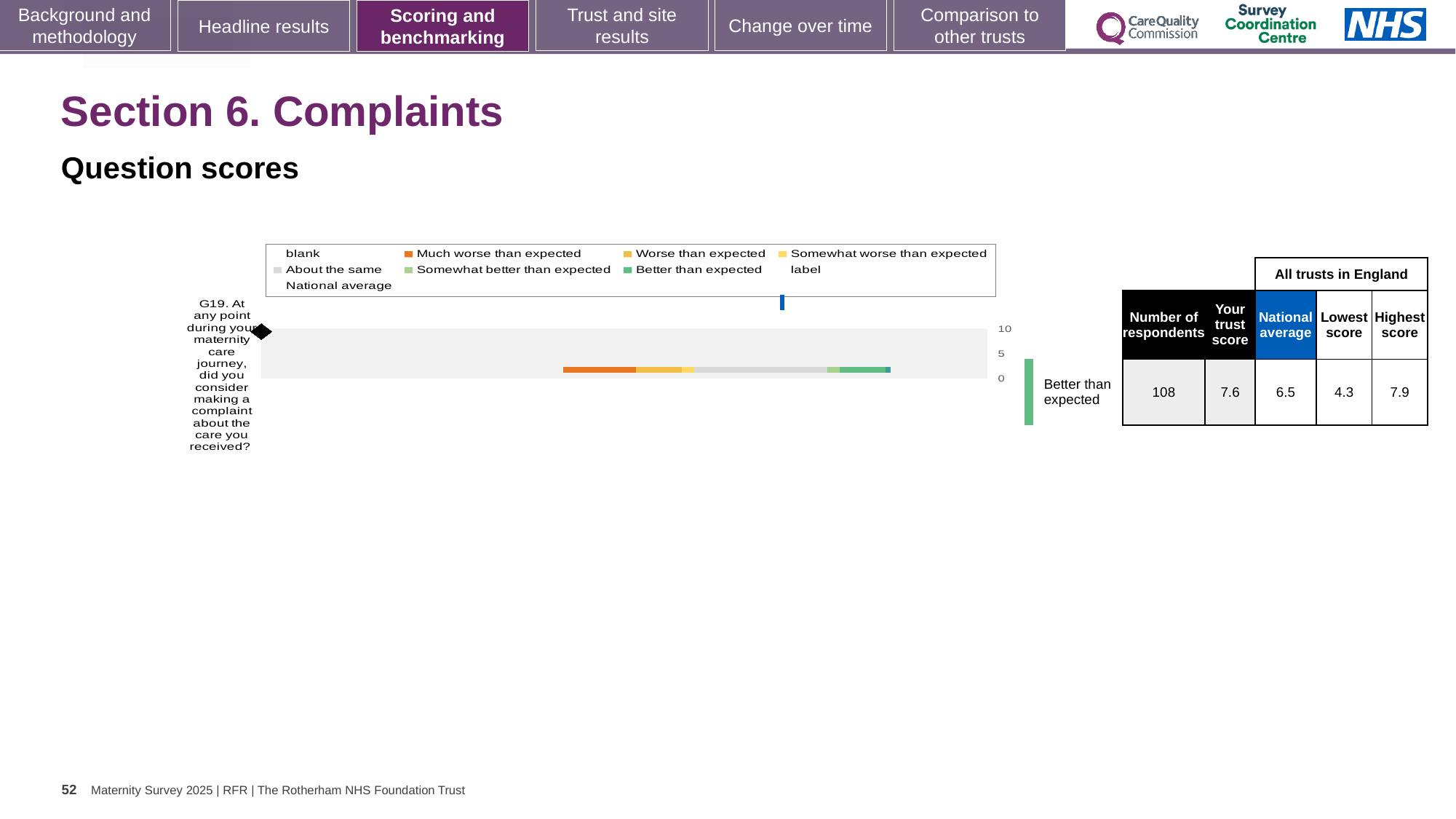
What is the trust score for G19 shown next to the chart? 7.6 What is the national average score for G19? 6.5 Is the trust score for G19 higher or lower than the national average? higher What is the difference between the highest and lowest scores for G19 across all trusts in England? 3.6 What kind of chart is shown for question G19? bar chart Which survey question is plotted in the chart? G19. At any point during your maternity care journey, did you consider making a complaint about the care you received? Which benchmark category does the trust's result for G19 fall into? Better than expected How many respondents answered question G19? 108 What is the lowest score among all trusts in England for G19? 4.3 What is the highest score among all trusts in England for G19? 7.9 What is the difference between the trust score and the national average for G19? 1.1 What is the highest tick value shown on the chart's score axis? 10